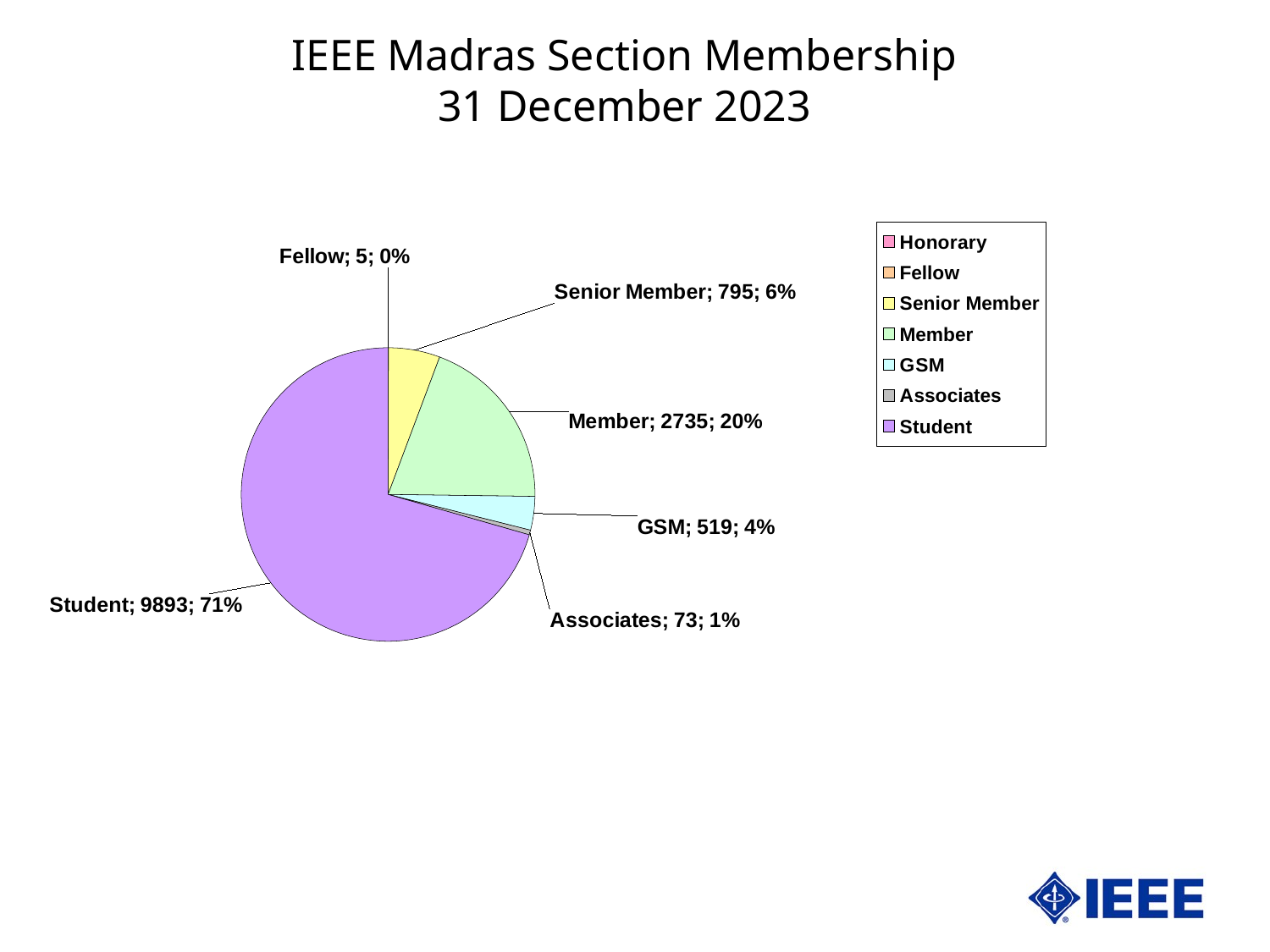
How many Senior Members are shown? 795 What share of the pie does the Student slice take? 71% Which labelled category has the smallest value? Fellow What kind of chart is shown on the slide? pie chart Which is larger, the GSM count or the Associates count? GSM What is the difference between the Member count and the Senior Member count? 1940 What is the value for GSM? 519 Which category has the largest slice of the pie? Student What percentage of the membership is Member? 20% What is the title of the chart? IEEE Madras Section Membership 31 December 2023 How many entries does the legend list? 7 How many members does the Student slice represent? 9893